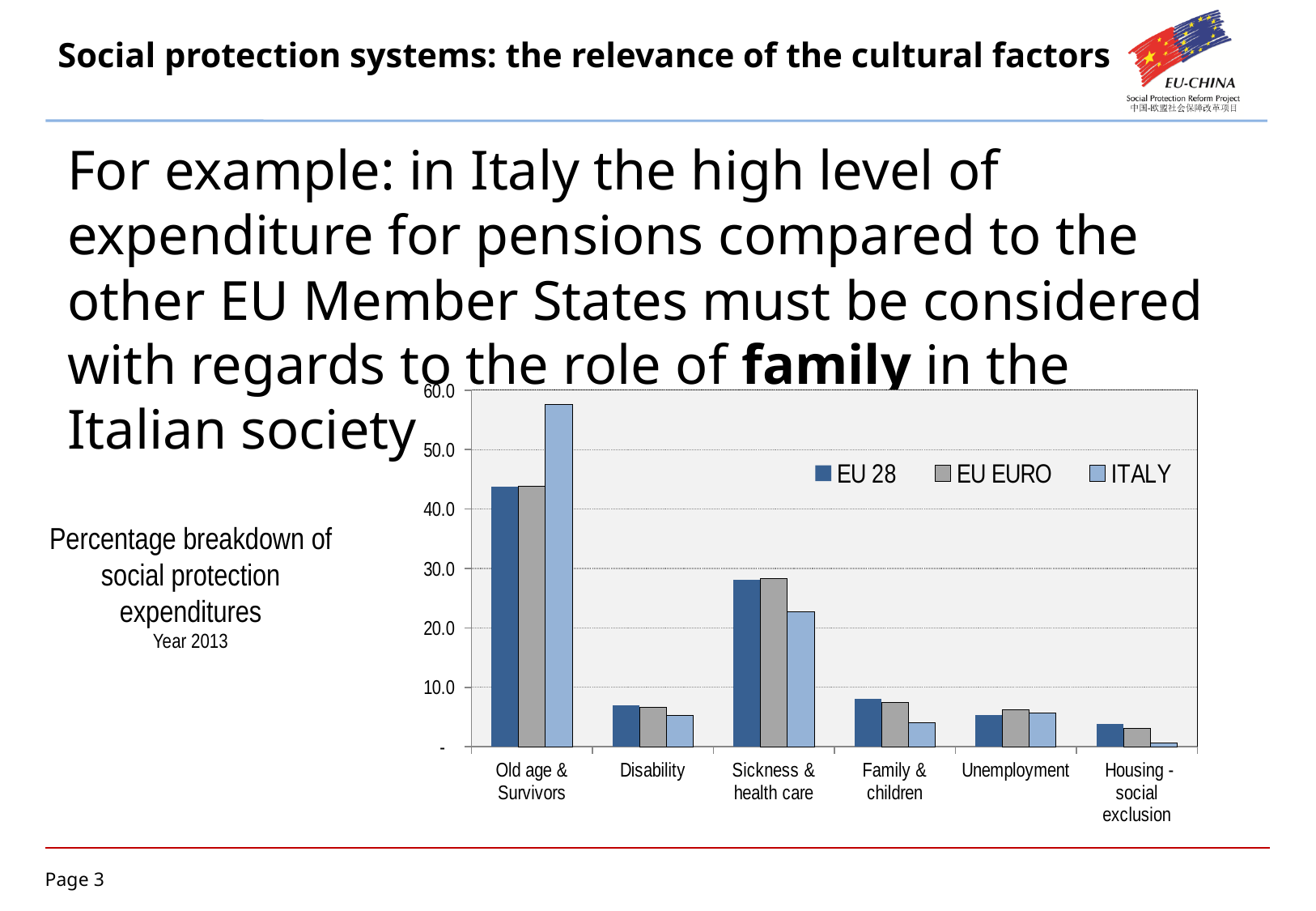
In the Sickness & health care category, which is larger: the value for EU 28 or the value for ITALY? EU 28 Is the value for ITALY in Sickness & health care greater or less than 20.0? greater Which category has the lowest value for ITALY? Housing - social exclusion Is the value for ITALY in Old age & Survivors greater or less than 50.0? greater In the Old age & Survivors category, which is larger: the value for ITALY or the value for EU 28? ITALY How many series does the chart's legend list? 3 Which category has the highest value for ITALY? Old age & Survivors What kind of chart is shown on the slide? bar chart Which year does the chart's data refer to, according to the caption on the slide? Year 2013 How many categories are shown on the x axis of the chart? 6 Is the value for EU 28 in Family & children greater or less than 10.0? less